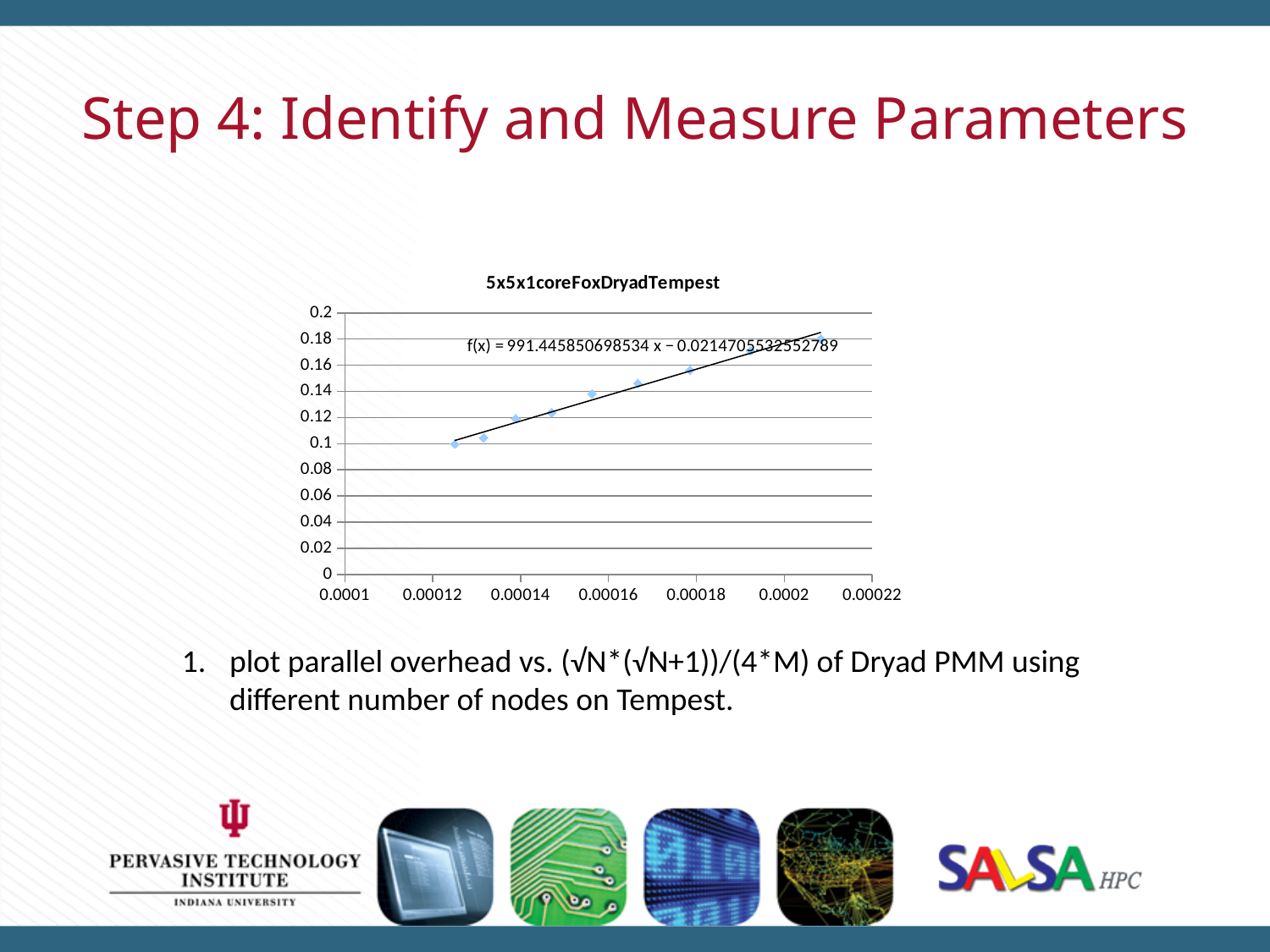
What is the highest value shown on the y-axis? 0.2 Do the plotted values rise or fall as the x-axis value increases? rise Is the value of the data point near x = 0.00018 greater or less than 0.14? greater Which data point has the highest value, the leftmost or the rightmost? the rightmost How many data points are plotted in the chart? 9 What is the trendline equation shown on the chart? f(x) = 991.445850698534 x − 0.0214705532552789 Is the value of the leftmost data point greater or less than 0.12? less Is the value of the data point near x = 0.00014 greater or less than 0.1? greater What is the title of the chart? 5x5x1coreFoxDryadTempest What kind of chart is shown on the slide? scatter chart